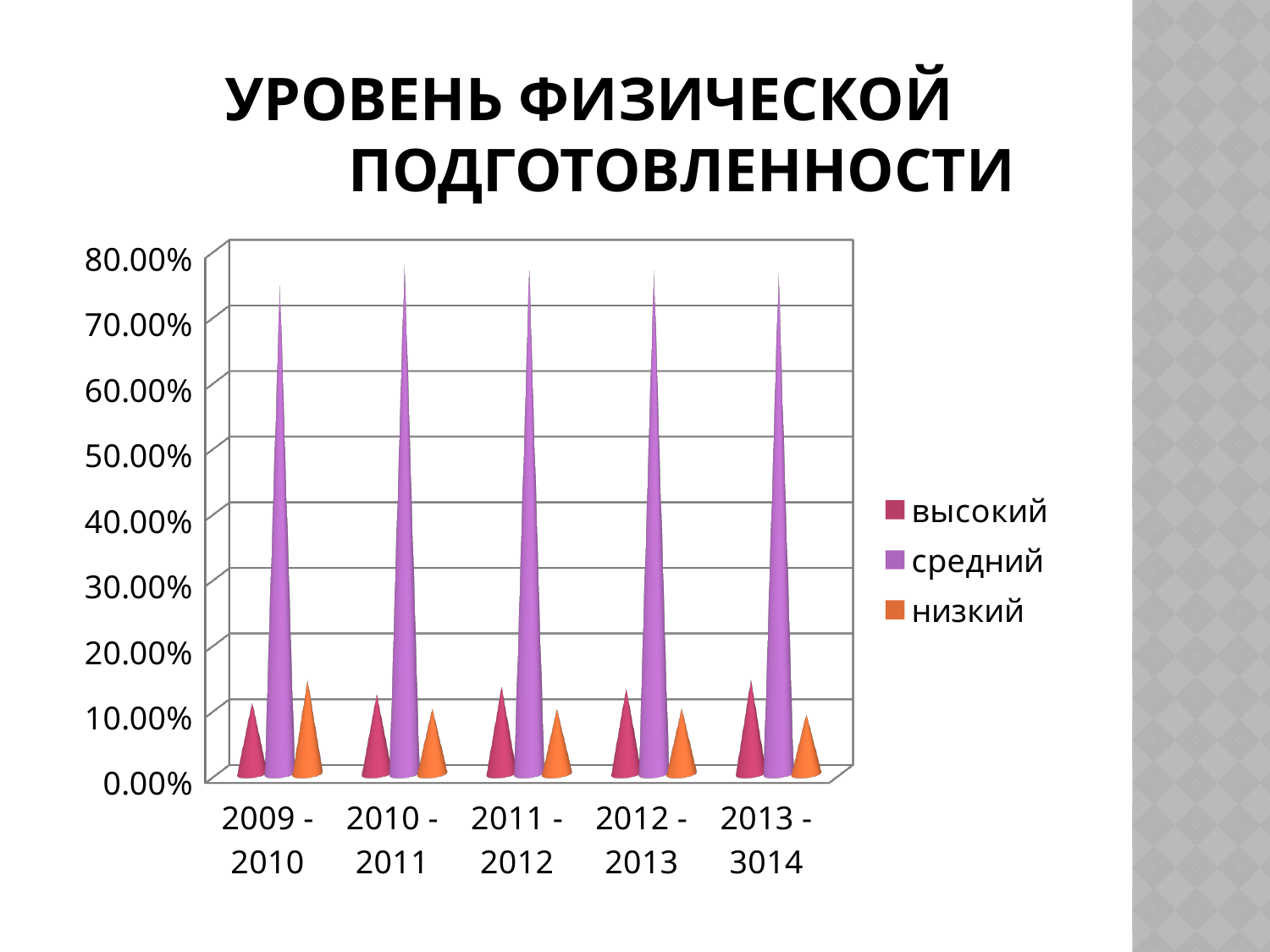
How many categories (school years) are shown on the x axis? 5 How many series does the legend list? 3 What is the title of the chart? УРОВЕНЬ ФИЗИЧЕСКОЙ ПОДГОТОВЛЕННОСТИ Is the value for низкий in 2009 - 2010 greater or less than 20.00%? less Which series is shown in purple in the legend? средний Is the value for средний in 2009 - 2010 greater or less than 70.00%? greater Is the value for высокий in 2013 - 3014 greater or less than 30.00%? less What kind of chart is shown on the slide? bar chart Which series has the lowest value in 2009 - 2010? высокий Which series has the highest value in 2009 - 2010? средний Which is larger in 2012 - 2013, the value for средний or the value for низкий? средний